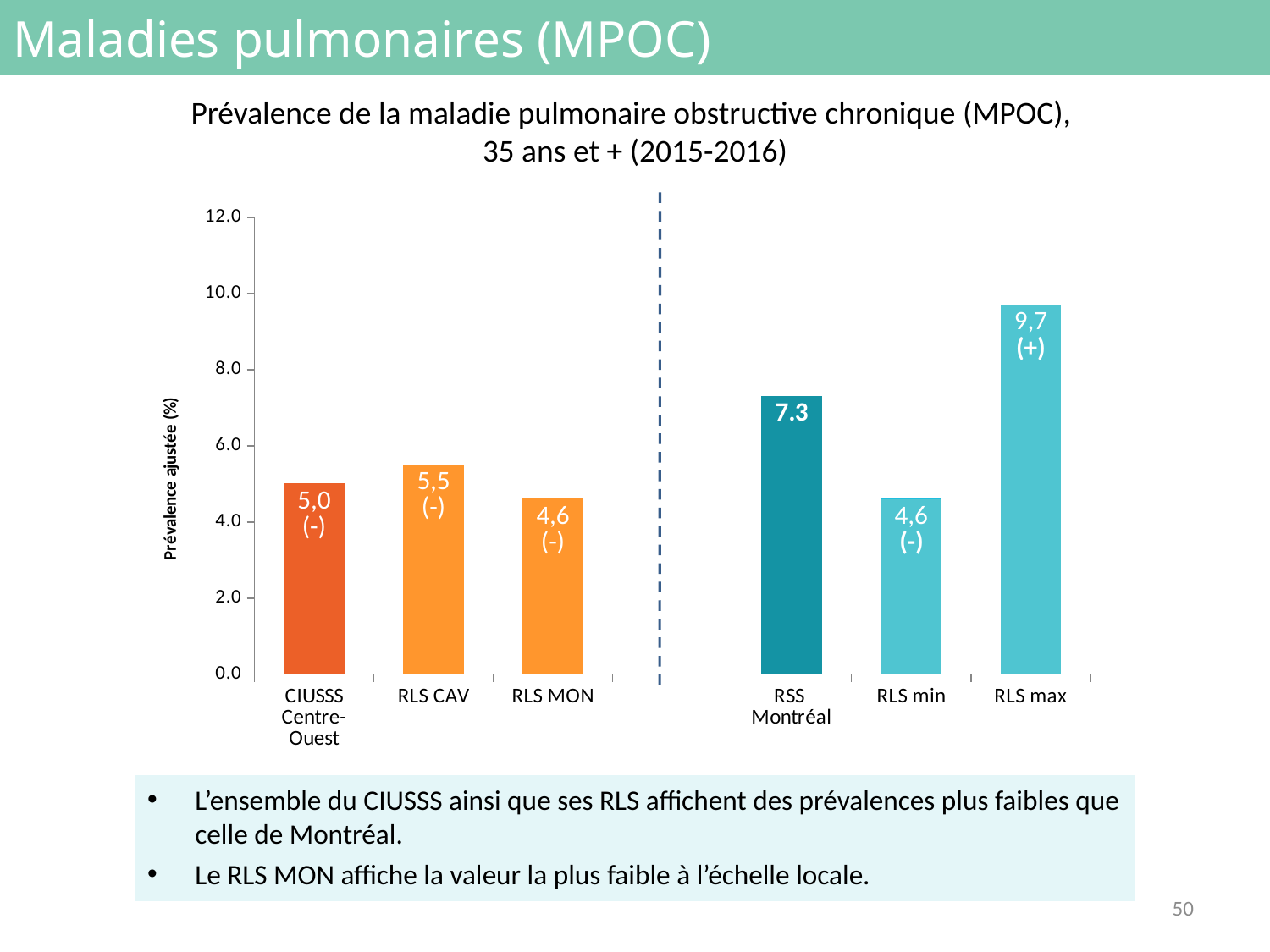
What is the difference between the values for RLS max and RLS min? 5,1 Which category has the highest value? RLS max What is the value for RLS CAV? 5,5 What is the value for RSS Montréal? 7.3 What is the value for RLS max? 9,7 What kind of chart is shown on the slide? Bar chart What is the difference between the values for RLS CAV and CIUSSS Centre-Ouest? 0,5 Among CIUSSS Centre-Ouest, RLS CAV and RLS MON, which has the lowest value? RLS MON Which is larger, the value for RLS CAV or the value for RSS Montréal? RSS Montréal What is the value for CIUSSS Centre-Ouest? 5,0 How many bars are plotted in the chart? 6 What is the label of the vertical axis? Prévalence ajustée (%)